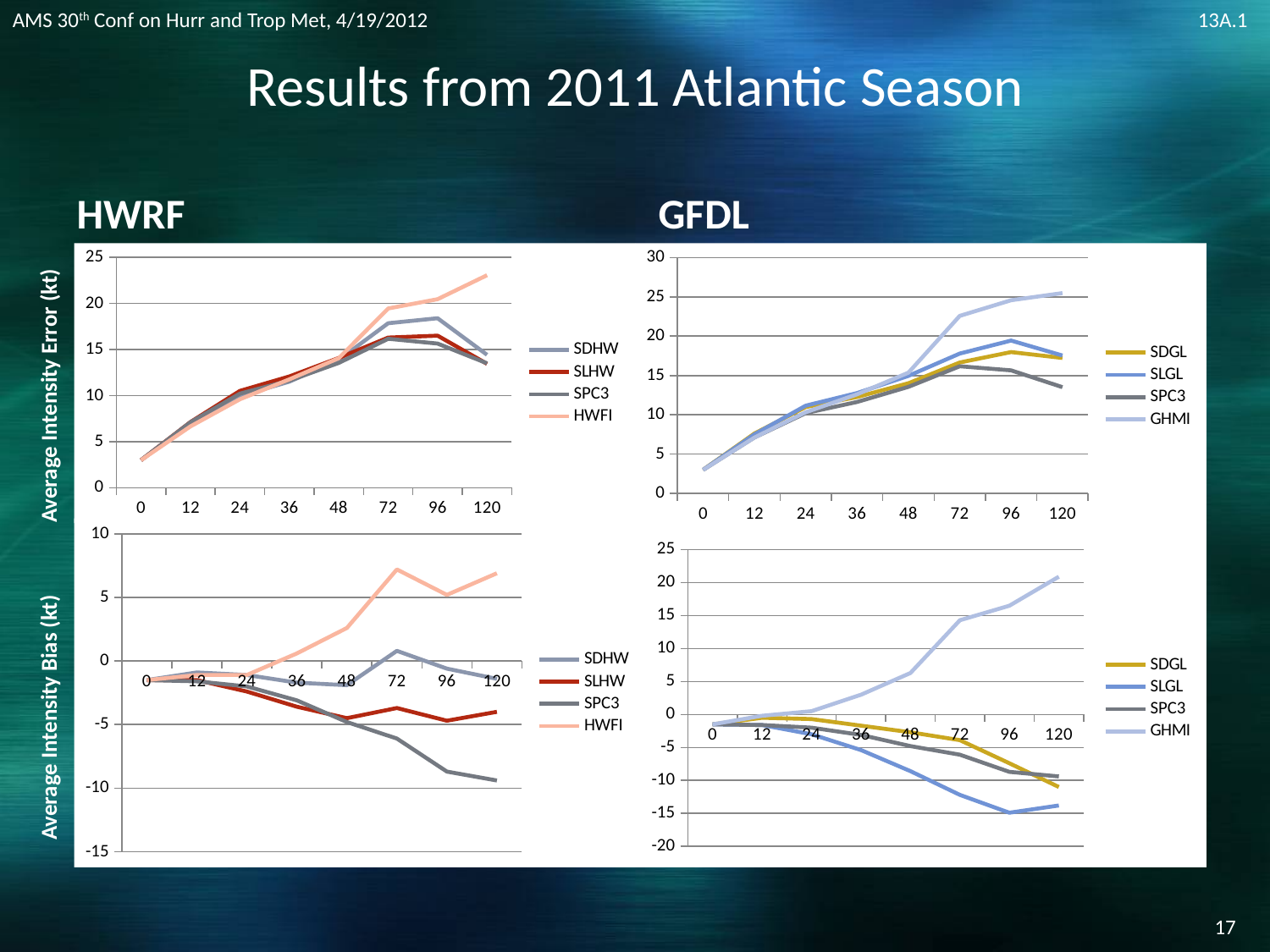
In the bottom-right GFDL Average Intensity Bias chart, which is larger at 96, GHMI or SLGL? GHMI How many series does the legend of the top-left HWRF Average Intensity Error chart list? 4 Which series in the bottom-right GFDL Average Intensity Bias chart is drawn in gold/yellow? SDGL In the top-right GFDL Average Intensity Error chart, which series has the lowest value at 120? SPC3 In the top-left HWRF Average Intensity Error chart, do the values generally rise or fall as forecast hour increases from 0 to 72? rise How many forecast-hour points are plotted along the x axis of the top-right GFDL Average Intensity Error chart? 8 What kind of chart is the top-left HWRF Average Intensity Error chart? line chart In the top-left HWRF Average Intensity Error chart, is the HWFI value at 120 greater or less than 20? greater In the bottom-left HWRF Average Intensity Bias chart, is the SPC3 value at 120 greater or less than -5? less In the bottom-left HWRF Average Intensity Bias chart, which series has the highest value at 120? HWFI In the top-right GFDL Average Intensity Error chart, is the GHMI value at 72 greater or less than 20? greater In the top-left HWRF Average Intensity Error chart, which series has the highest value at 120? HWFI